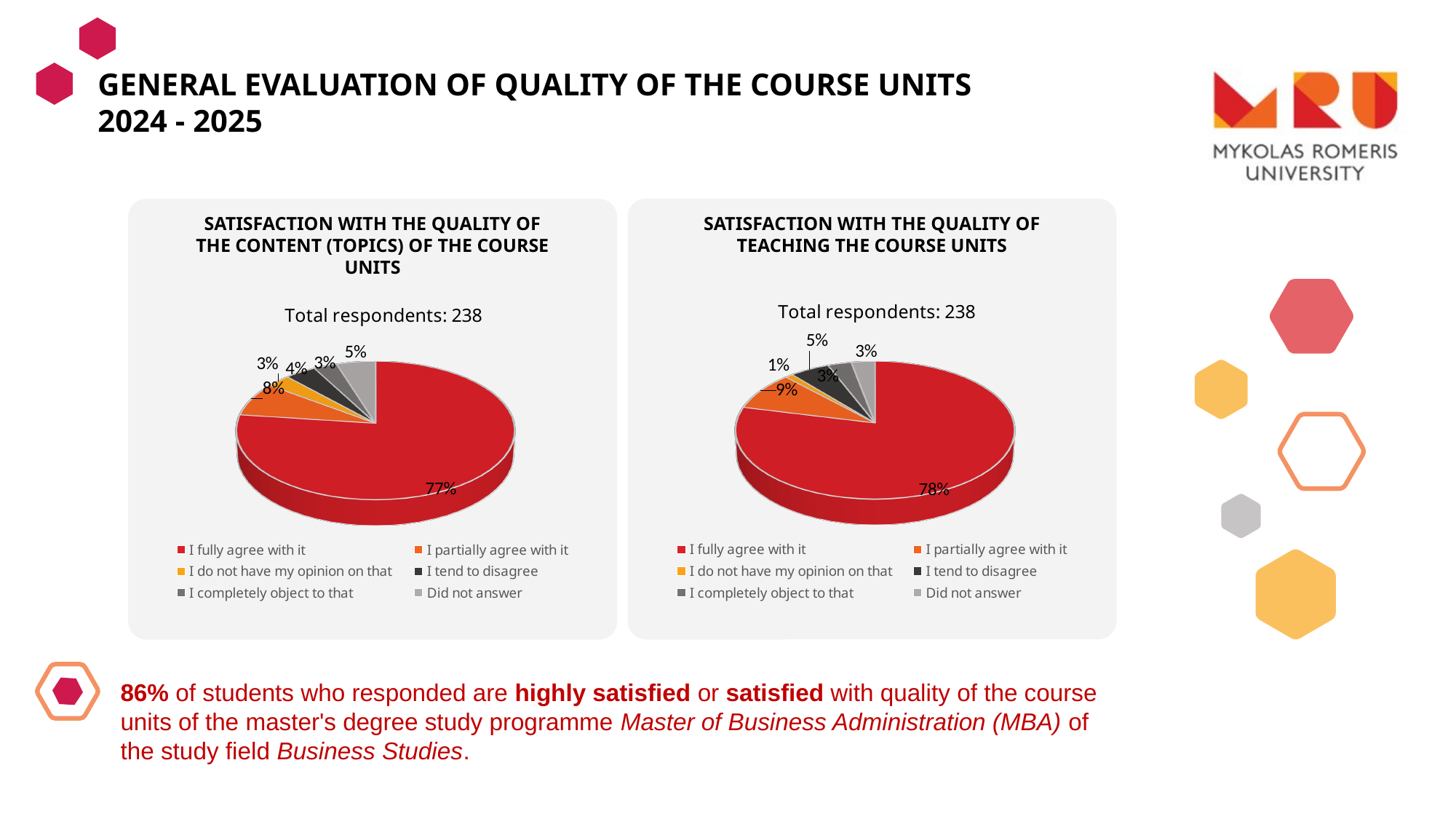
How many response categories does the legend of the left chart list? 6 In the right chart (teaching the course units), which response category has the largest slice? I fully agree with it In the left chart (content of the course units), what share of respondents chose 'I partially agree with it'? 8% In the left chart (content of the course units), what is the difference in percentage points between 'I fully agree with it' and 'I partially agree with it'? 69 percentage points In the left chart (content of the course units), what percentage of respondents did not answer? 5% In the chart titled 'Satisfaction with the quality of teaching the course units', what percentage of respondents chose 'I fully agree with it'? 78% In the right chart (teaching the course units), which response category has the smallest slice? I do not have my opinion on that How many total respondents are reported for the chart on the right? 238 What type of charts are shown on the slide? Pie charts In the chart titled 'Satisfaction with the quality of the content (topics) of the course units', what percentage of respondents chose 'I fully agree with it'? 77% Which chart shows a higher share for 'I fully agree with it': the content chart on the left or the teaching chart on the right? The teaching chart on the right (78%) In the right chart (teaching the course units), what share of respondents chose 'I do not have my opinion on that'? 1%